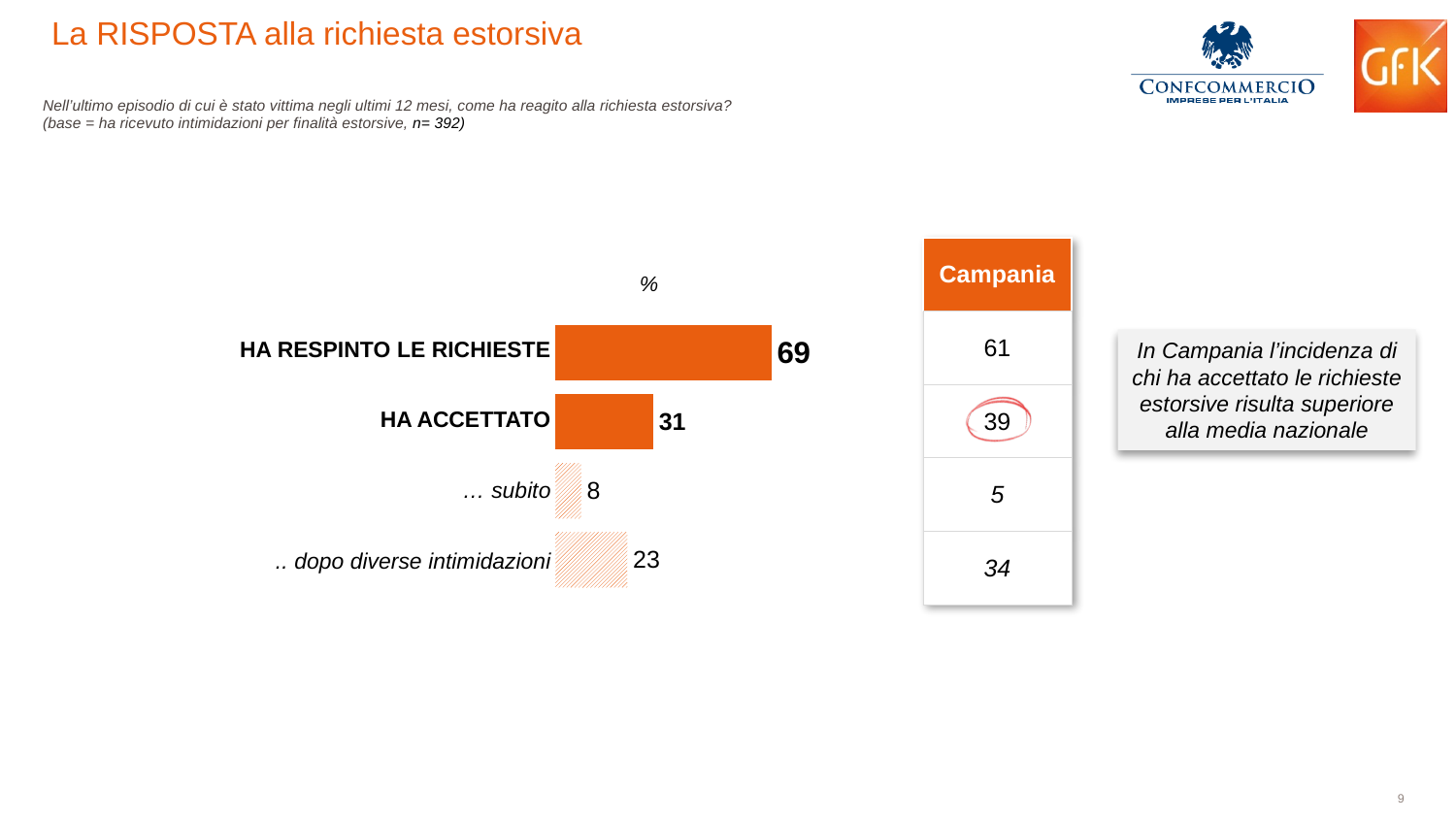
What is the value for "… subito" in the bar chart? 8 How many categories are shown in the bar chart? 4 What is the value for "HA RESPINTO LE RICHIESTE" in the bar chart? 69 What is the value for "HA ACCETTATO" in the bar chart? 31 Which is larger in the bar chart: "… subito" or ".. dopo diverse intimidazioni"? .. dopo diverse intimidazioni What kind of chart is shown on the slide? Bar chart What is the difference between the values for "HA RESPINTO LE RICHIESTE" and "HA ACCETTATO"? 38 What unit label is shown above the bars in the chart? % Which category has the lowest value in the bar chart? … subito What is the value for ".. dopo diverse intimidazioni" in the bar chart? 23 What is the difference between the values for ".. dopo diverse intimidazioni" and "… subito"? 15 Which category has the highest value in the bar chart? HA RESPINTO LE RICHIESTE